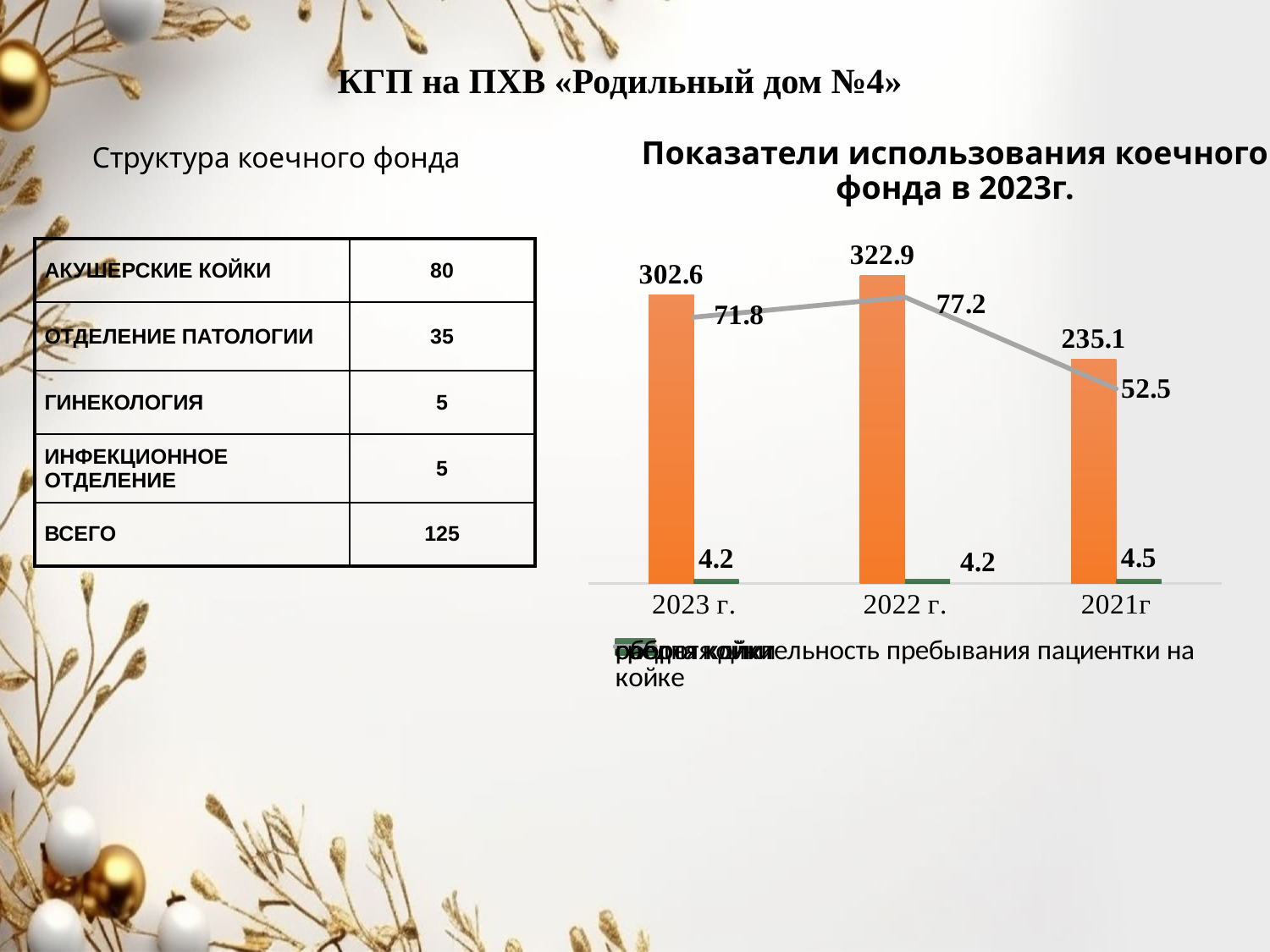
Which is larger, the gray line value for 2023 г. or for 2022 г.? 2022 г. Which year has the highest orange bar? 2022 г. Which year has the lowest value on the gray line? 2021г What is the value of the orange bar for 2021г? 235.1 How many years are shown on the x axis of the chart? 3 Does the gray line rise or fall from 2022 г. to 2021г? fall What value does the gray line show for 2023 г.? 71.8 What is the value of the small green bar for 2021г? 4.5 What is the difference between the orange bar values for 2022 г. and 2021г? 87.8 What is the title of the chart? Показатели использования коечного фонда в 2023г. What value does the gray line show for 2021г? 52.5 What is the value of the orange bar for 2022 г.? 322.9